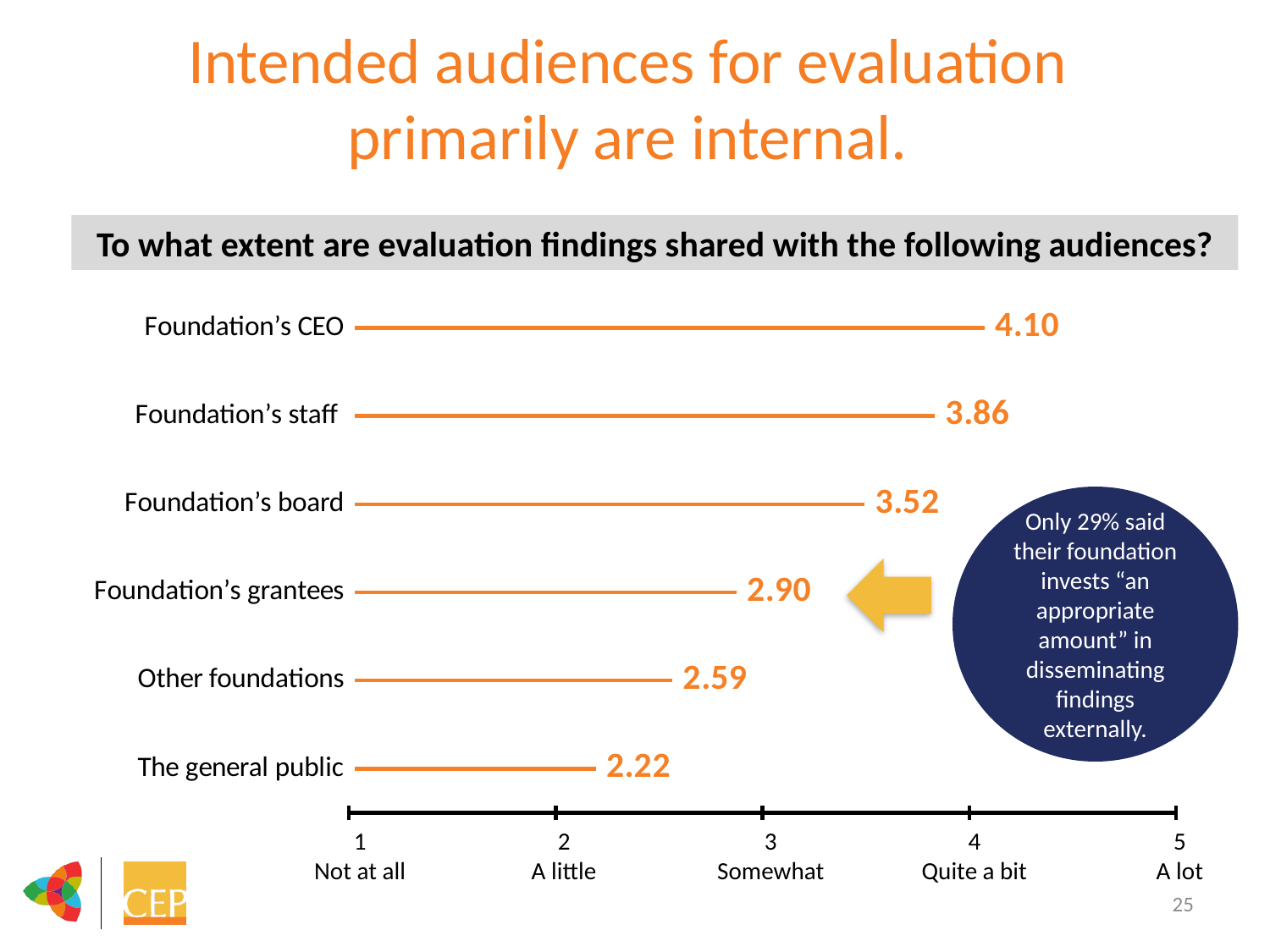
What is the value for The general public? 2.22 What is the value for Foundation's grantees? 2.90 What is the label for the scale point 5 on the x axis? A lot Is the value for Foundation's staff greater or less than 3? greater What is the difference between the values for Foundation's board and The general public? 1.30 What is the value for Foundation's CEO? 4.10 Which is larger, the value for Foundation's board or the value for Foundation's grantees? Foundation's board How many audiences are shown in the chart? 6 Which audience has the highest value? Foundation's CEO What is the value for Other foundations? 2.59 Which audience has the lowest value? The general public What is the difference between the values for Foundation's CEO and Foundation's staff? 0.24